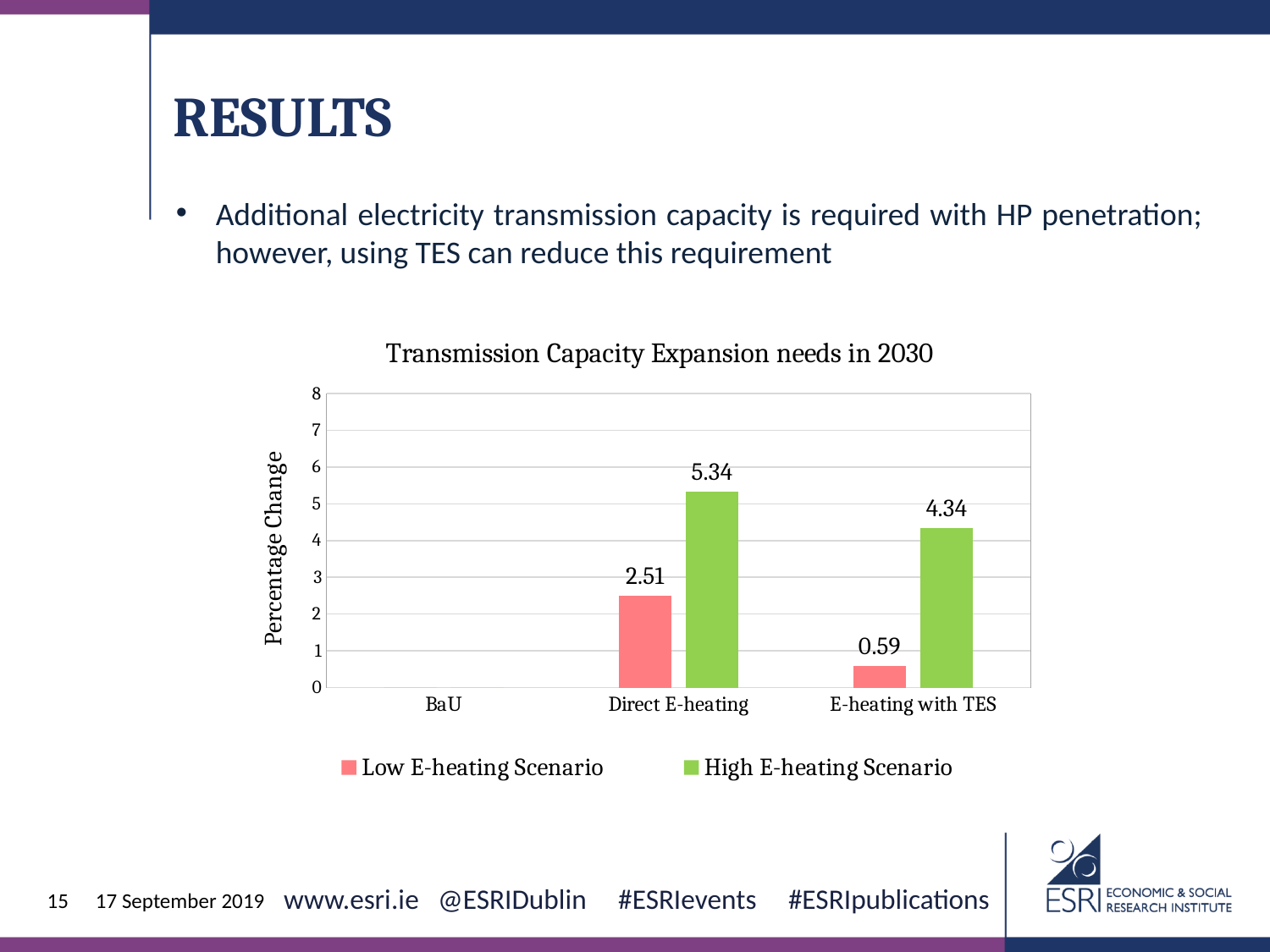
What is the value for the High E-heating Scenario under E-heating with TES? 4.34 What is the difference between the High E-heating Scenario values for Direct E-heating and E-heating with TES? 1 Which category has the highest value for the High E-heating Scenario? Direct E-heating What is the value for the High E-heating Scenario under Direct E-heating? 5.34 What is the value for the Low E-heating Scenario under E-heating with TES? 0.59 What is the title of the chart? Transmission Capacity Expansion needs in 2030 Is the High E-heating Scenario value for E-heating with TES greater or less than 4? greater How many categories are shown on the x axis? 3 How many series does the legend list? 2 What is the value for the Low E-heating Scenario under Direct E-heating? 2.51 What is the difference between the Low and High E-heating Scenario values for Direct E-heating? 2.83 Which is larger: the Low E-heating Scenario value for Direct E-heating or for E-heating with TES? Direct E-heating